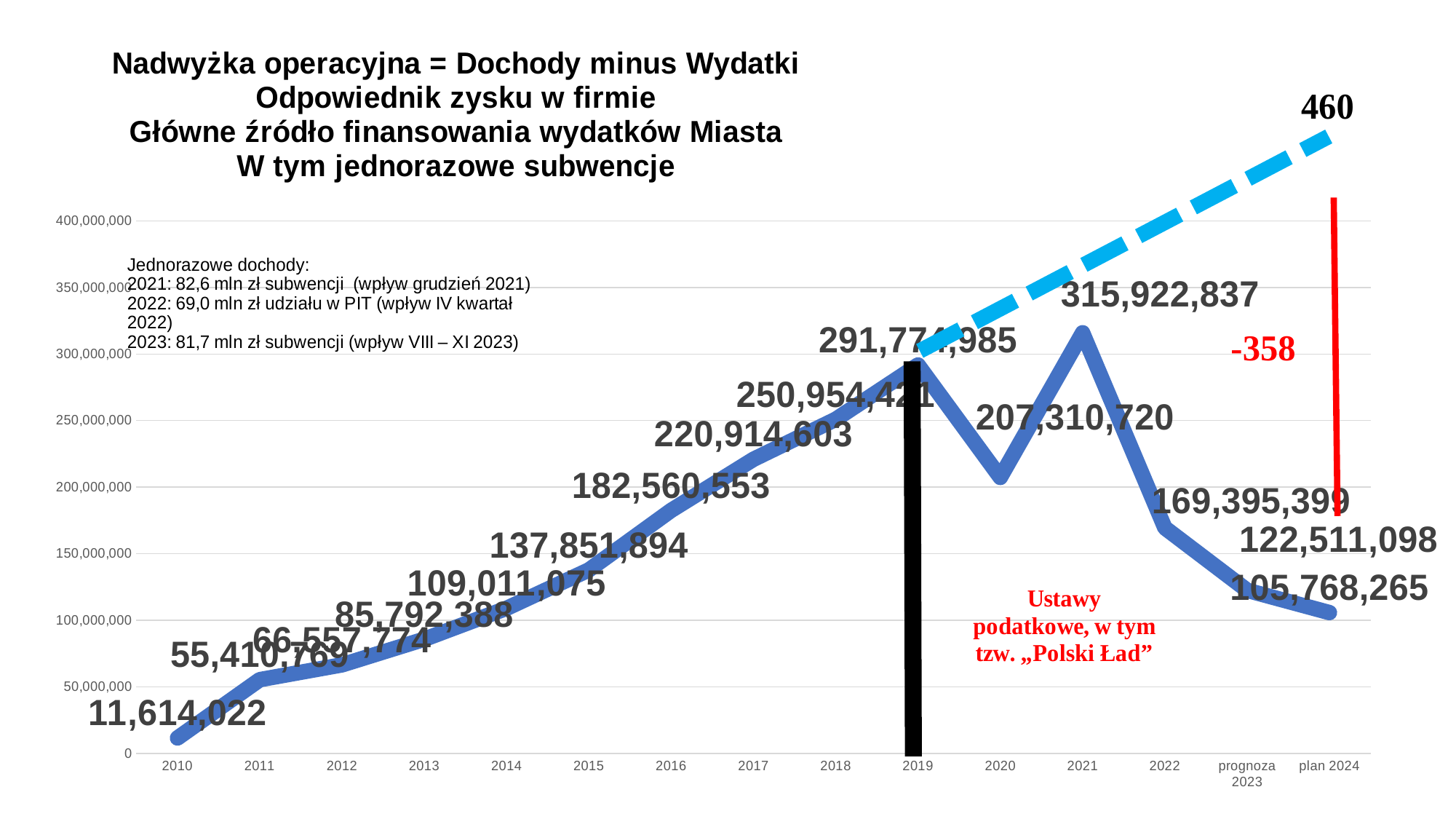
What is the value for plan 2024? 105,768,265 Which year has the highest value? 2021 What is the value for 2020? 207,310,720 What type of chart is shown on the slide? line chart What is the difference between the values for 2021 and 2020? 108,612,117 How many data points are plotted on the x axis? 15 Which is larger, the value for 2019 or the value for 2021? 2021 Is the value for 2022 greater or less than 150,000,000? greater Do the values rise or fall from 2010 to 2019? rise What is the value for 2021? 315,922,837 Which year has the lowest value? 2010 What is the value for 2010? 11,614,022